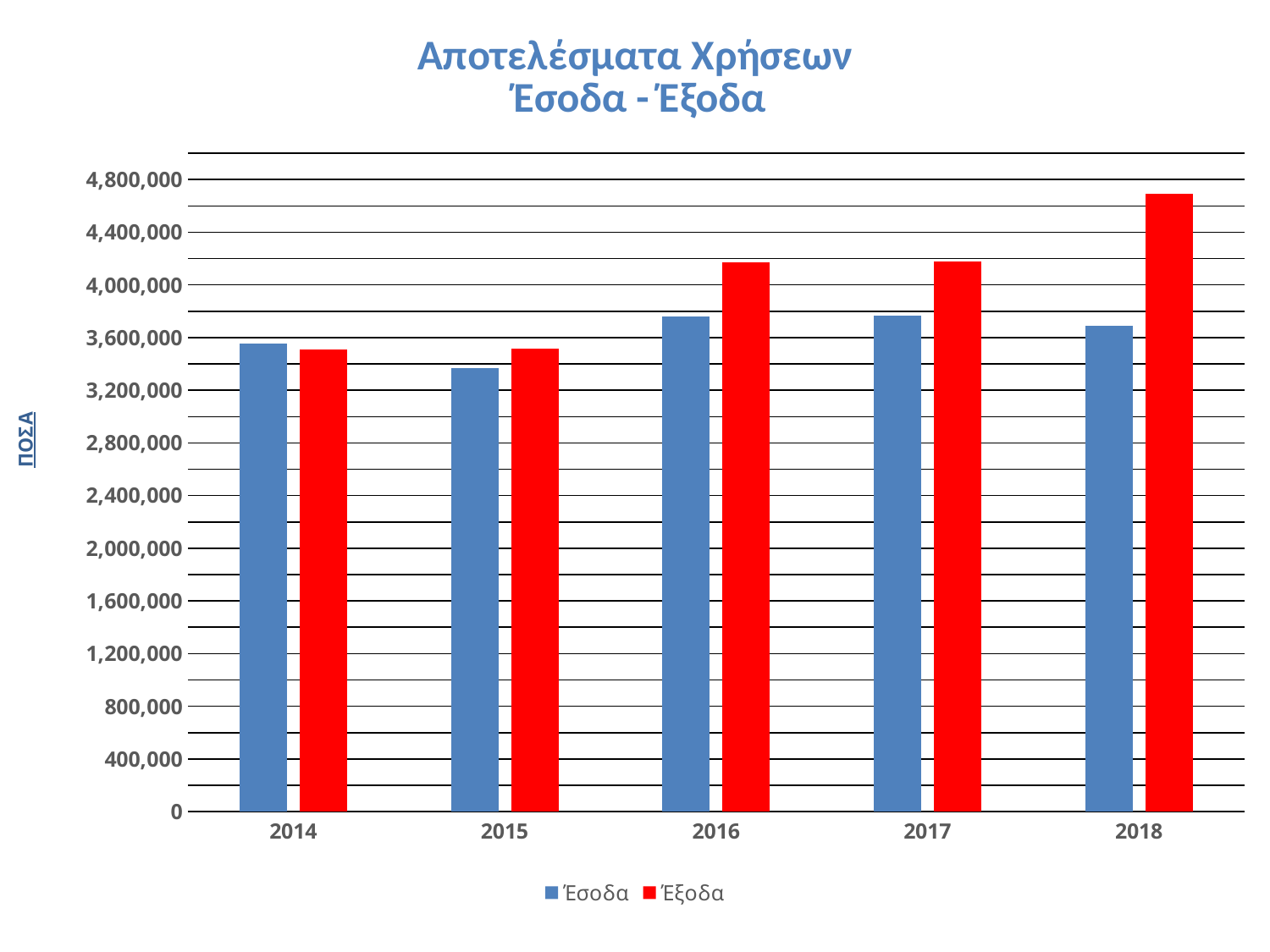
In 2018, which is larger, Έσοδα or Έξοδα? Έξοδα Does Έξοδα generally rise or fall from 2014 to 2018? Rise What is the label on the vertical axis? ΠΟΣΑ How many years are shown on the x axis? 5 In which year is Έσοδα lowest? 2015 Is the value for Έξοδα in 2018 greater or less than 4,400,000? greater In 2016, which is larger, Έσοδα or Έξοδα? Έξοδα What kind of chart is shown on the slide? Bar chart Is the value for Έσοδα in 2015 greater or less than 3,600,000? less How many series does the legend list? 2 Is the value for Έξοδα in 2016 greater or less than 4,000,000? greater In which year is Έξοδα highest? 2018